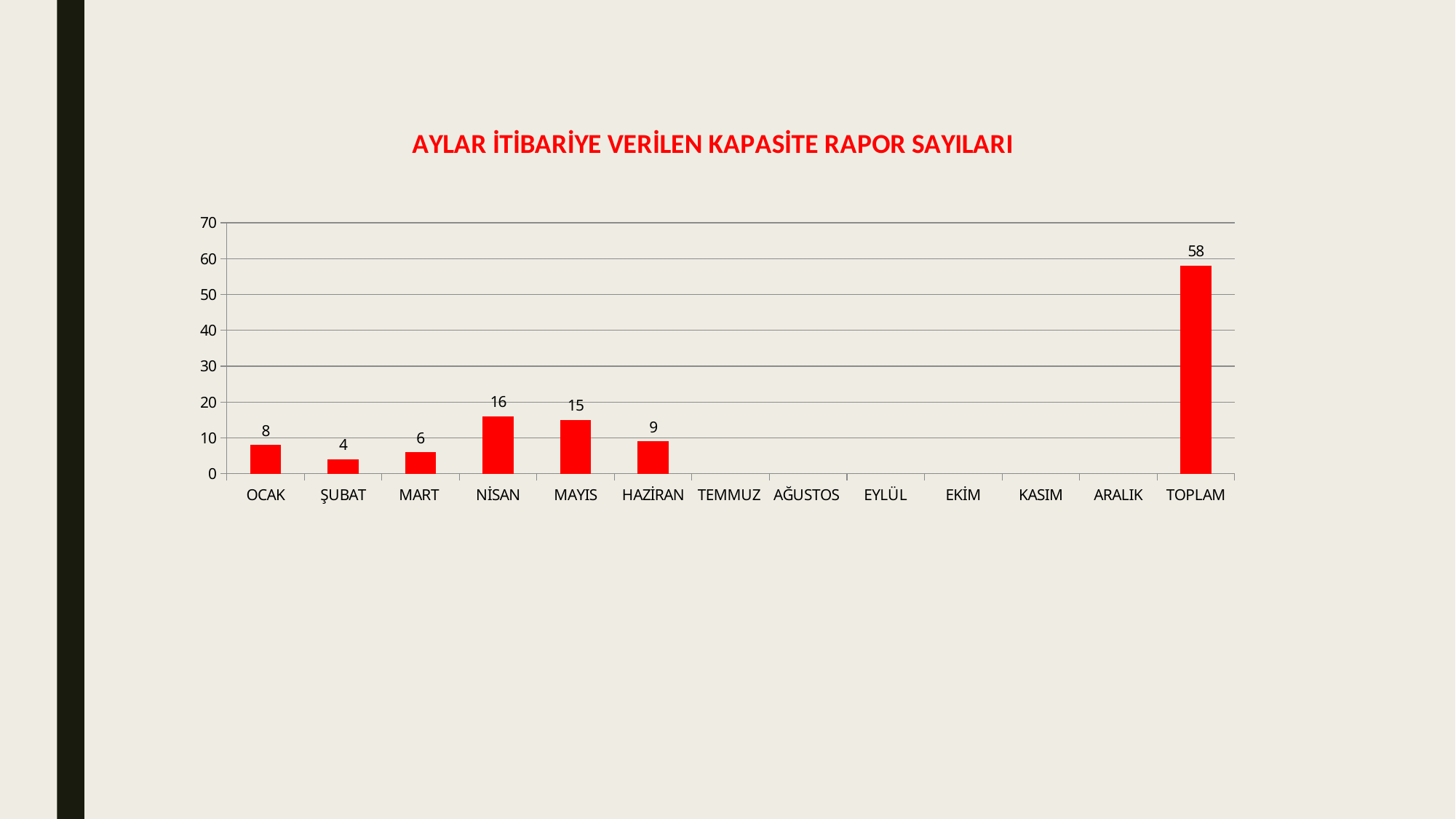
Which is larger, the value for OCAK or the value for MAYIS? MAYIS Is the value for TOPLAM greater or less than 50? greater What is the title of the chart? AYLAR İTİBARİYE VERİLEN KAPASİTE RAPOR SAYILARI What is the value for TOPLAM? 58 What is the value for NİSAN? 16 What is the difference between the values for NİSAN and MART? 10 Among the months with a visible bar, which has the lowest value? ŞUBAT Among the months (excluding TOPLAM), which has the highest value? NİSAN What is the value for ŞUBAT? 4 What is the value for HAZİRAN? 9 What kind of chart is this? bar chart How many categories are shown on the x axis? 13